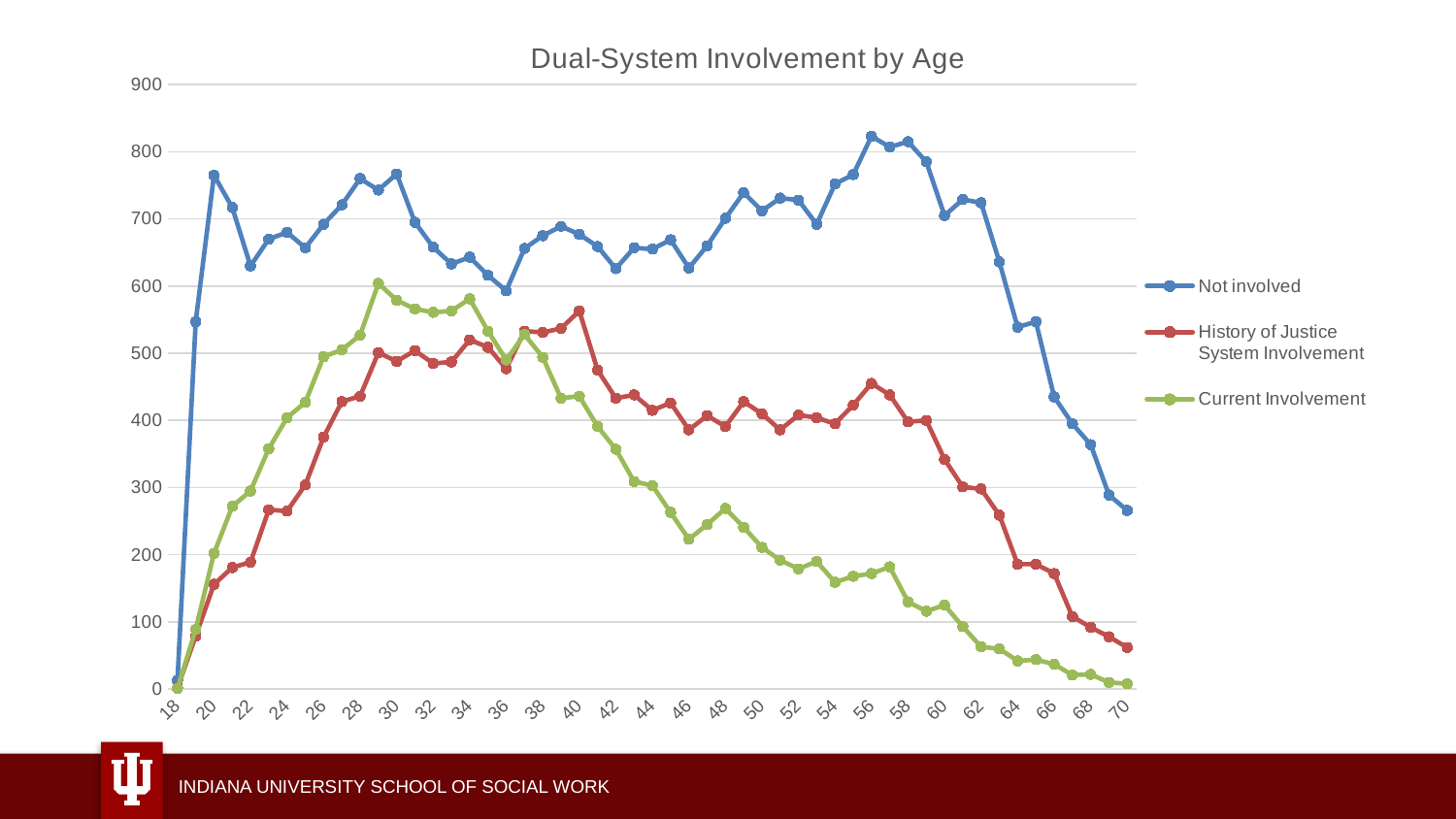
Do the Current Involvement values rise or fall from age 50 to age 70? fall At age 36, which is larger: Not involved or History of Justice System Involvement? Not involved Is the value for Current Involvement at age 70 greater or less than 100? less Which colour is used for the Not involved series? blue Which series has the highest values across the chart? Not involved What is the title of the chart? Dual-System Involvement by Age Is the value for Not involved at age 56 greater or less than 800? greater What kind of chart is shown on the slide? line chart Which series has the lowest value at age 70? Current Involvement Is the value for History of Justice System Involvement at age 40 greater or less than 500? greater How many series does the legend list? 3 At age 46, which is larger: History of Justice System Involvement or Current Involvement? History of Justice System Involvement